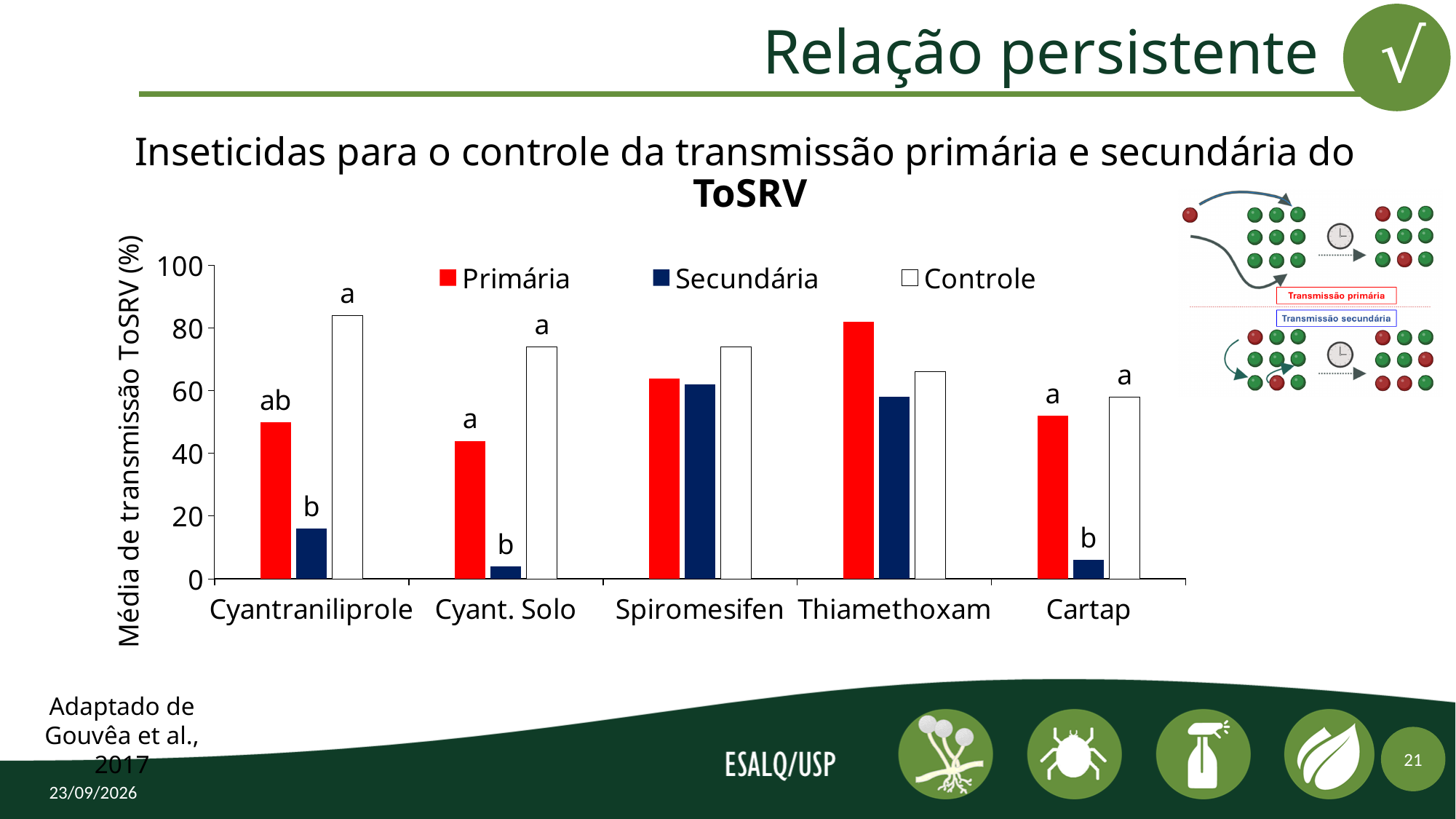
What kind of chart is shown on the slide? bar chart How many insecticide categories are shown on the x axis? 5 What is the title of the y axis? Média de transmissão ToSRV (%) How many series does the legend list? 3 Which insecticide has the highest Controle value? Cyantraniliprole Is the Secundária value for Cyant. Solo greater or less than 20? less For Cyantraniliprole, which is larger: the Primária value or the Secundária value? Primária Which insecticide has the highest Primária value? Thiamethoxam Is the Primária value for Thiamethoxam greater or less than 60? greater Is the Secundária value for Spiromesifen greater or less than 40? greater Which insecticide has the lowest Controle value? Cartap For Thiamethoxam, which is larger: the Primária value or the Controle value? Primária